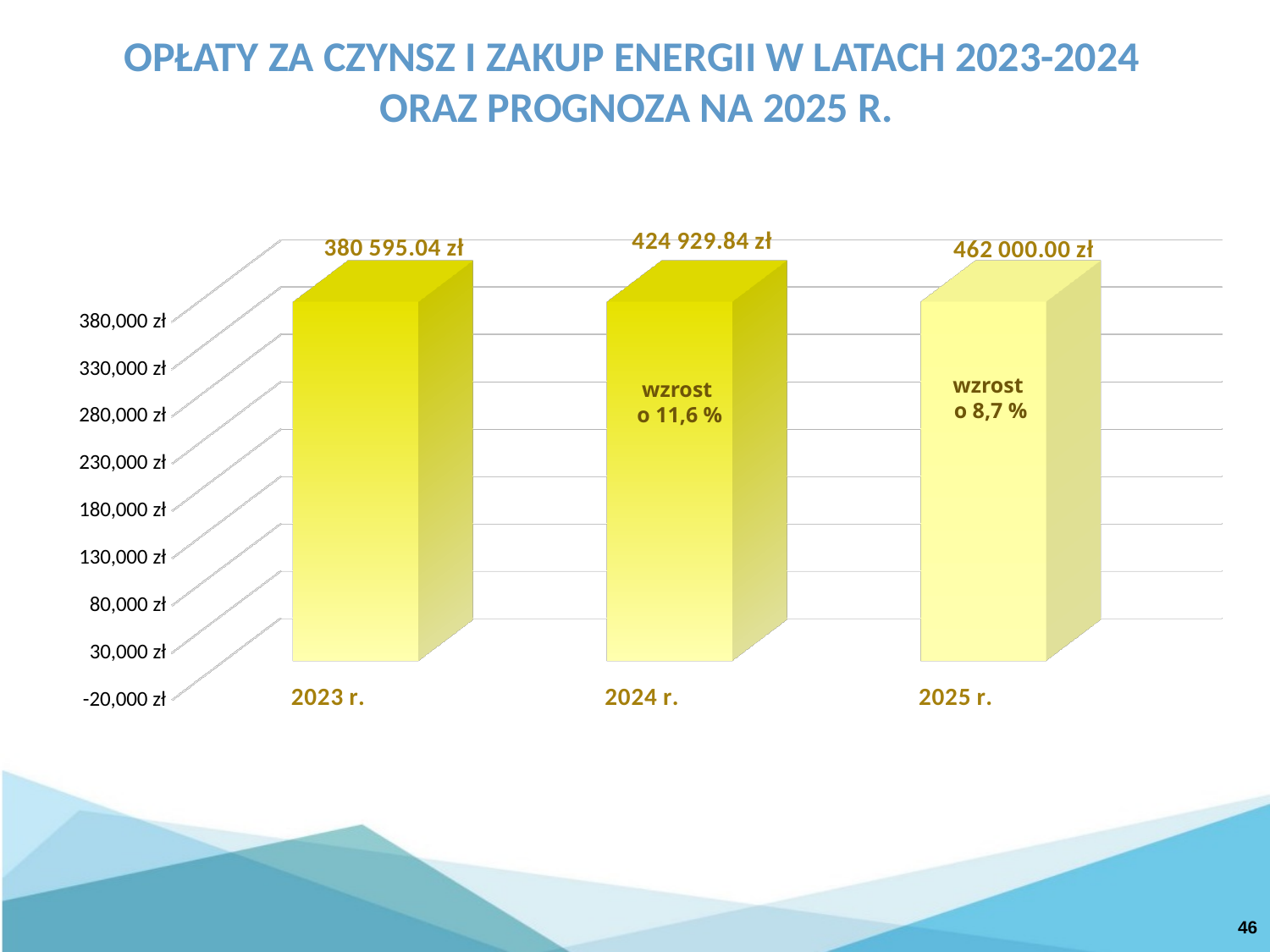
What is the value shown for 2023 r.? 380 595.04 zł What is the difference between the values for 2024 r. and 2023 r.? 44 334.80 zł What is the value shown for 2025 r.? 462 000.00 zł What is the difference between the values for 2025 r. and 2024 r.? 37 070.16 zł Which is larger, the value for 2024 r. or the value for 2025 r.? 2025 r. What percentage increase is annotated on the bar for 2024 r.? wzrost o 11,6 % Do the values rise or fall from 2023 r. to 2025 r.? Rise What is the value shown for 2024 r.? 424 929.84 zł Which year has the highest value? 2025 r. Which year has the lowest value? 2023 r. How many years (categories) are shown in the chart? 3 What kind of chart is shown on the slide? Bar chart